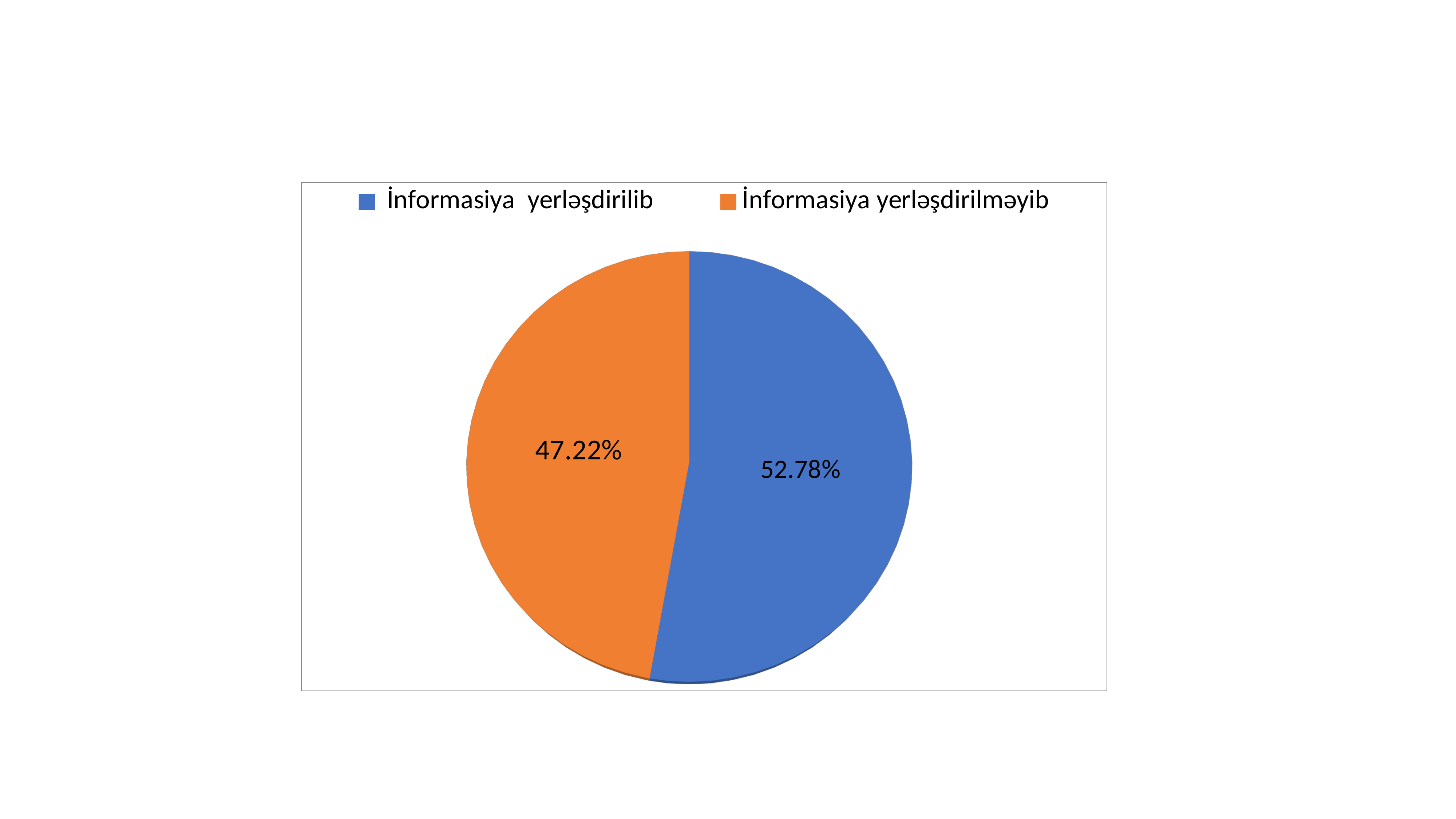
What kind of chart is shown on the slide? Pie chart What is the difference between the İnformasiya yerləşdirilib and İnformasiya yerləşdirilməyib slices? 5.56% How many slices does the pie chart have? 2 Which is larger, İnformasiya yerləşdirilib or İnformasiya yerləşdirilməyib? İnformasiya yerləşdirilib What is the value for İnformasiya yerləşdirilməyib? 47.22% What share of the pie does İnformasiya yerləşdirilib take? 52.78% Which slice is the smallest? İnformasiya yerləşdirilməyib What is the value for İnformasiya yerləşdirilib? 52.78% What colour is the İnformasiya yerləşdirilməyib slice? Orange What colour is the İnformasiya yerləşdirilib slice? Blue How many entries does the legend list? 2 Which slice is the largest? İnformasiya yerləşdirilib